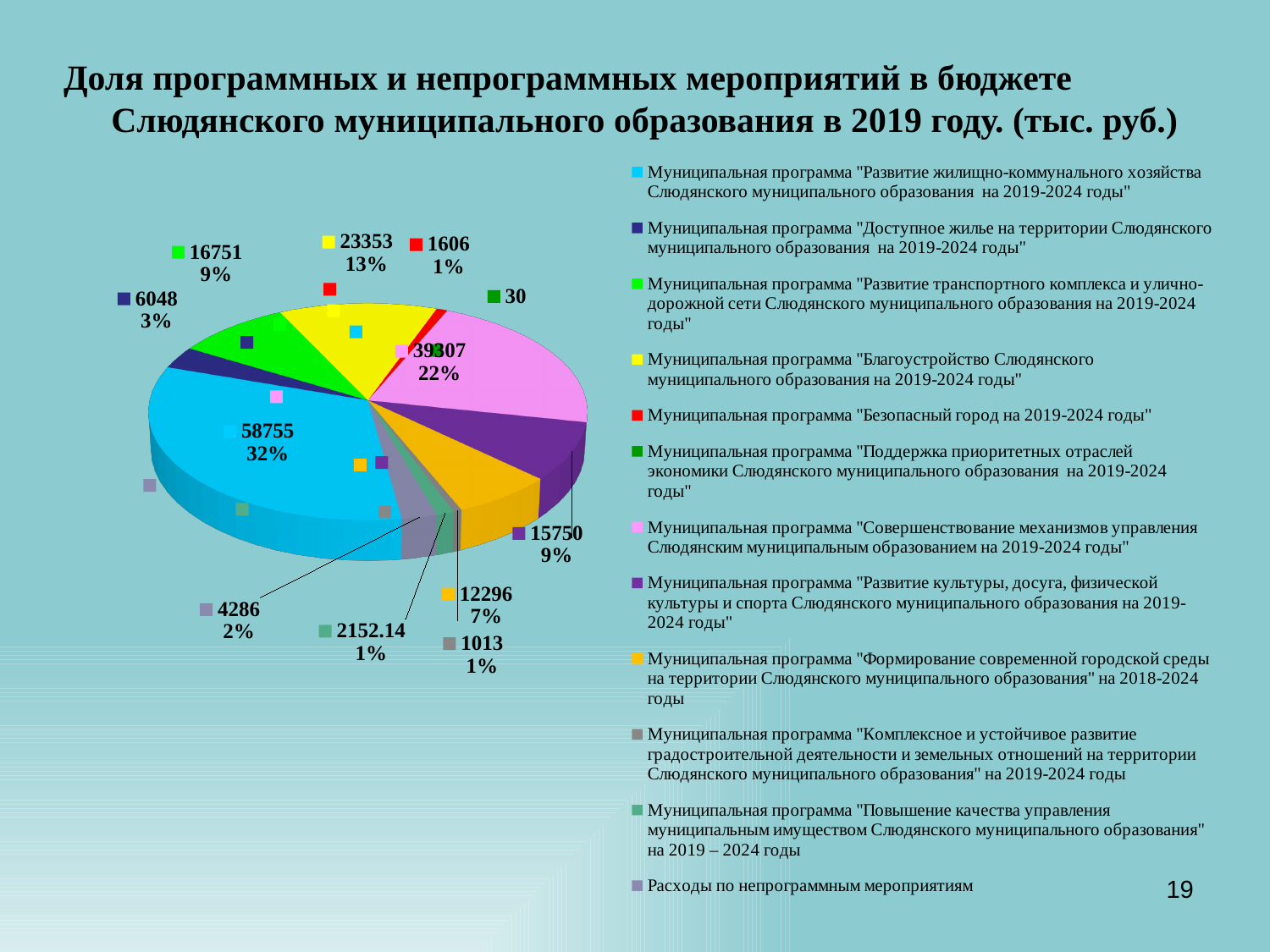
How many entries does the legend of the pie chart list? 12 What is the difference between the value for "Благоустройство" (23353) and the value for "Развитие транспортного комплекса" (16751)? 6602 Which programme has the smallest value in the pie chart? Муниципальная программа "Поддержка приоритетных отраслей экономики" (30) What share of the pie does the programme "Совершенствование механизмов управления" take? 22% What is the value for the programme "Безопасный город"? 1606 What is the value (тыс. руб.) for the programme "Развитие жилищно-коммунального хозяйства"? 58755 What is the value for "Расходы по непрограммным мероприятиям"? 4286 What is the value for the programme "Благоустройство Слюдянского муниципального образования"? 23353 Which is larger: the value for "Развитие культуры, досуга, физической культуры и спорта" or the value for "Формирование современной городской среды"? Развитие культуры, досуга, физической культуры и спорта What kind of chart is shown on the slide? Pie chart What share of the pie does the programme "Развитие жилищно-коммунального хозяйства" take? 32% Which programme has the largest slice of the pie? Муниципальная программа "Развитие жилищно-коммунального хозяйства"